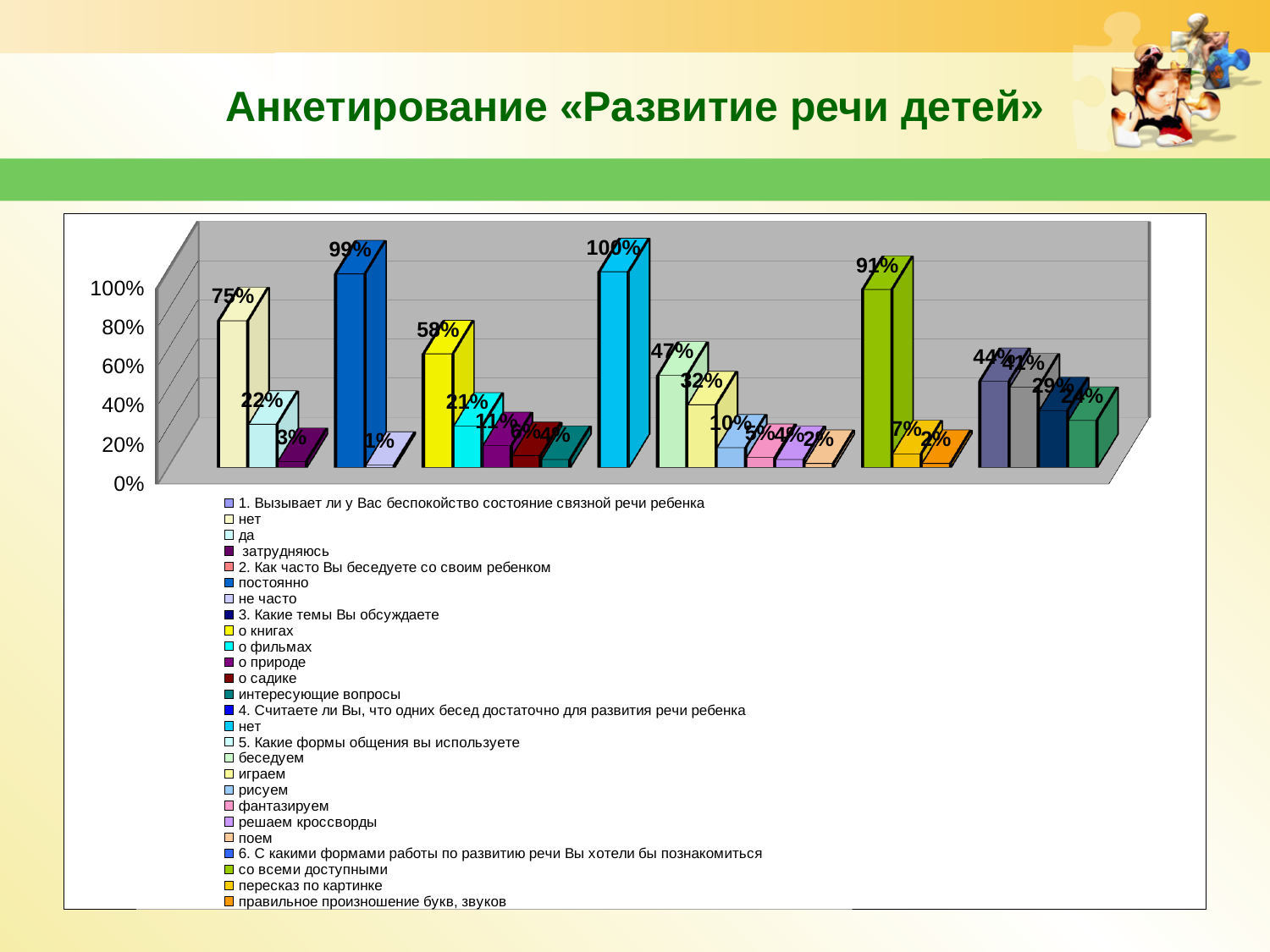
What is the value for "нет" in the first group (question 1, "Вызывает ли у Вас беспокойство состояние связной речи ребенка")? 75% What is the value for "не часто" (question 2)? 1% What is the value for "беседуем" (question 5, "Какие формы общения вы используете")? 47% Which bar has the highest value on the chart? нет (question 4), 100% Which is larger: the value for "беседуем" or the value for "играем" (question 5)? беседуем What is the value for "нет" under question 4 ("Считаете ли Вы, что одних бесед достаточно для развития речи ребенка")? 100% What type of chart is shown on the slide? bar chart What is the value for "со всеми доступными" (question 6)? 91% What is the value for "о книгах" (question 3, "Какие темы Вы обсуждаете")? 58% What is the value for "да" in the first group (question 1)? 22% What is the value for "постоянно" (question 2, "Как часто Вы беседуете со своим ребенком")? 99% What is the difference between the values for "постоянно" and "не часто" (question 2)? 98%